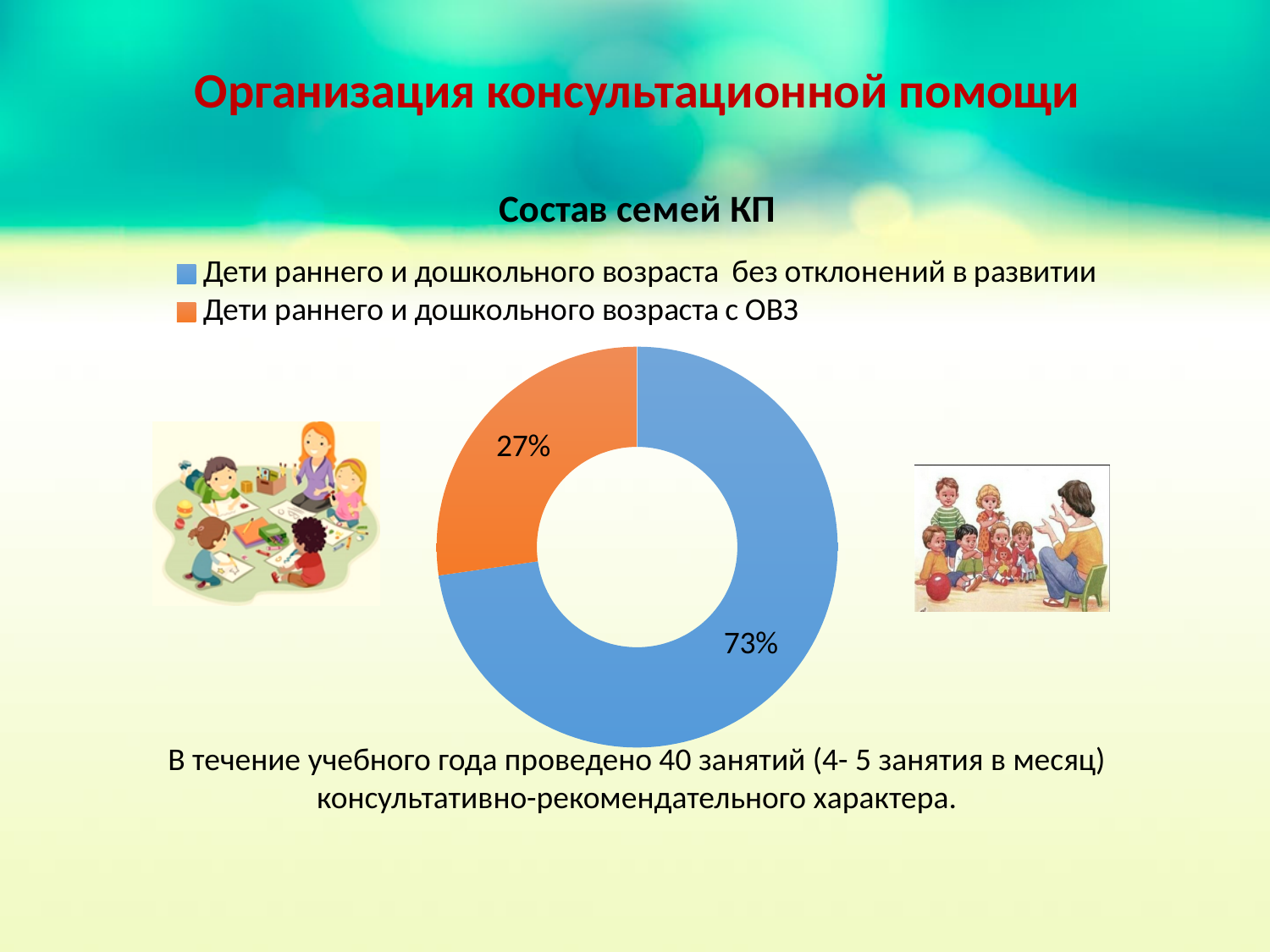
What share of the chart is 'Дети раннего и дошкольного возраста с ОВЗ'? 27% How many categories does the chart show? 2 What is the difference in percentage points between the two slices of the chart? 46 Which category has the largest share in the chart? Дети раннего и дошкольного возраста без отклонений в развитии How many entries does the legend list? 2 What kind of chart is shown on the slide? Doughnut (pie) chart Which is larger: the share of children without developmental deviations or the share of children with ОВЗ? Дети раннего и дошкольного возраста без отклонений в развитии Which category has the smallest share in the chart? Дети раннего и дошкольного возраста с ОВЗ What share of the chart is 'Дети раннего и дошкольного возраста без отклонений в развитии'? 73% What is the title of the chart? Состав семей КП What colour is the slice for 'Дети раннего и дошкольного возраста с ОВЗ'? Orange